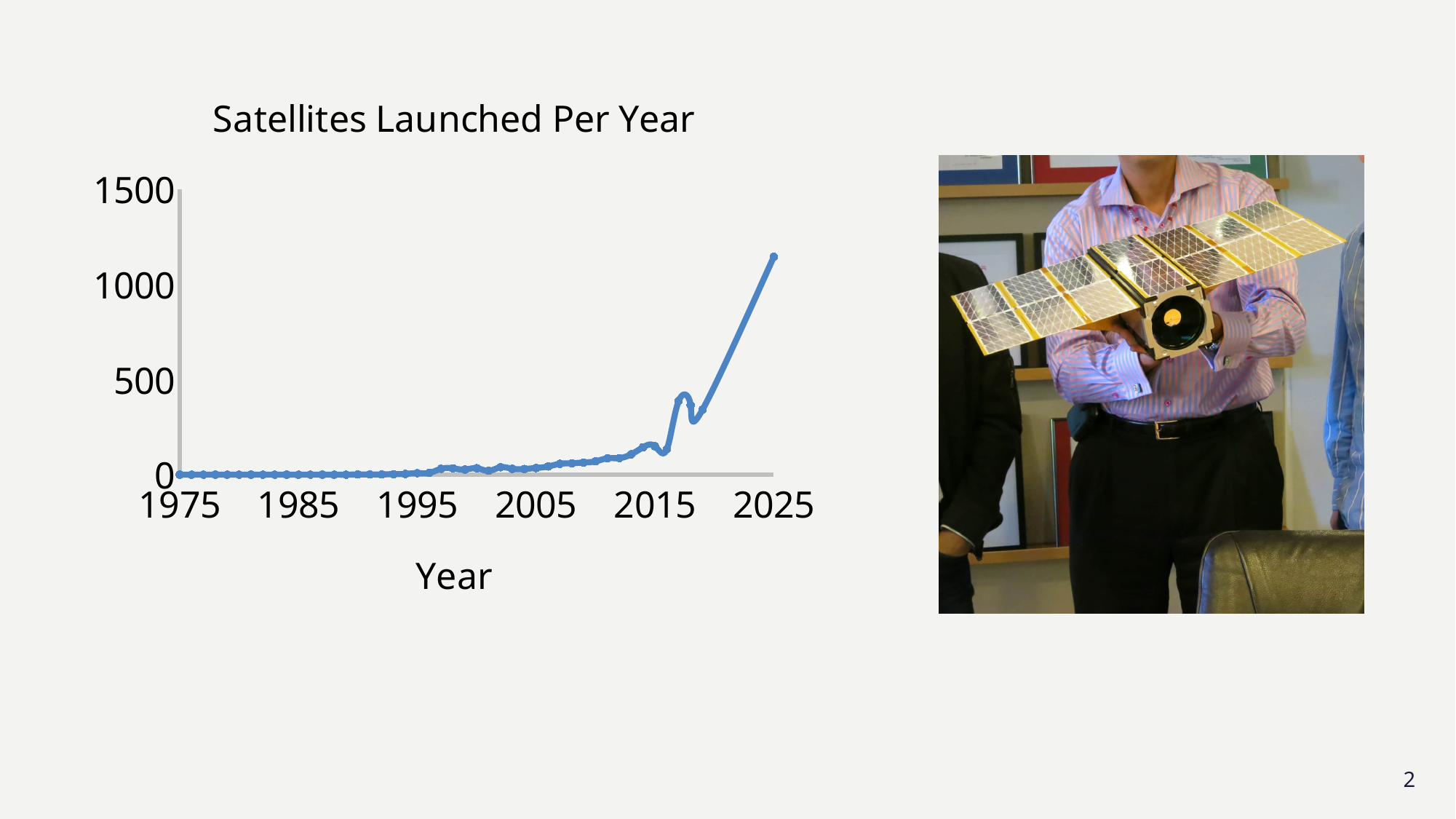
What kind of chart is shown on the slide? line chart Is the value for 2015 greater or less than 1000? less How many lines (series) are plotted in the chart? 1 Is the value for the final year (2025) greater or less than 1000? greater Overall, do the values in the chart rise or fall from 1975 to 2025? rise Which is larger, the value for 1995 or the value for 2025? 2025 Is the value for 1985 greater or less than 500? less Around which year does the chart reach its highest value? 2025 Which is larger, the value for 2015 or the value for 2025? 2025 What is the title of the chart? Satellites Launched Per Year What is the label on the x axis of the chart? Year